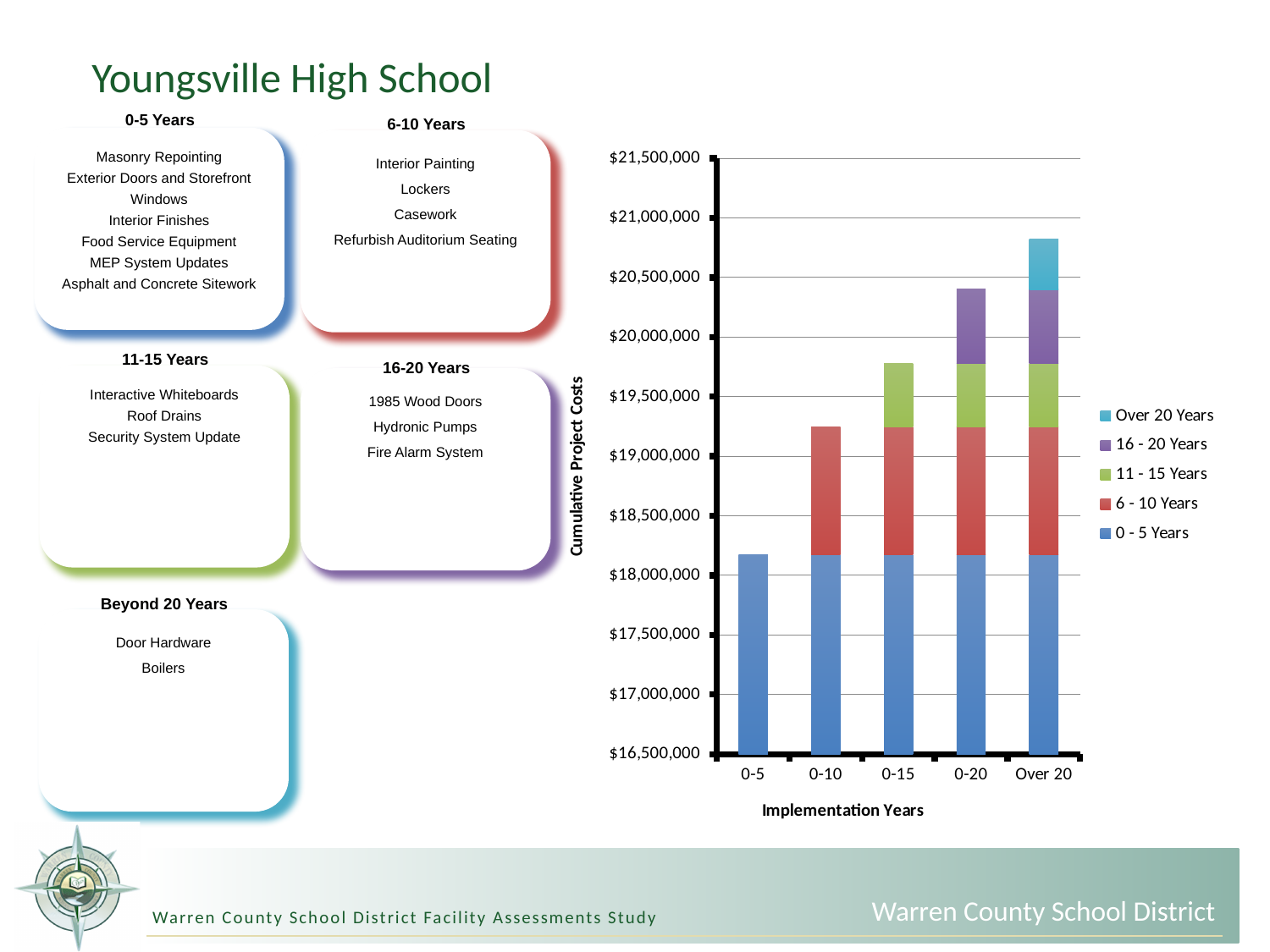
Is the total cumulative project cost for the Over 20 bar greater or less than $20,500,000? greater Which bar is taller, 0-20 or 0-10? 0-20 What is the title of the chart's horizontal axis? Implementation Years Is the total cumulative project cost for the 0-5 bar greater or less than $18,000,000? greater What is the title of the chart's vertical axis? Cumulative Project Costs Which implementation-years category has the lowest cumulative project cost? 0-5 Which implementation-years category has the highest cumulative project cost? Over 20 How many series does the chart's legend list? 5 Do the cumulative project costs rise or fall from 0-5 to Over 20 along the x axis? Rise What kind of chart is shown on the slide? Stacked bar chart Is the total cumulative project cost for the 0-10 bar greater or less than $19,500,000? less How many categories are shown on the x axis of the chart? 5